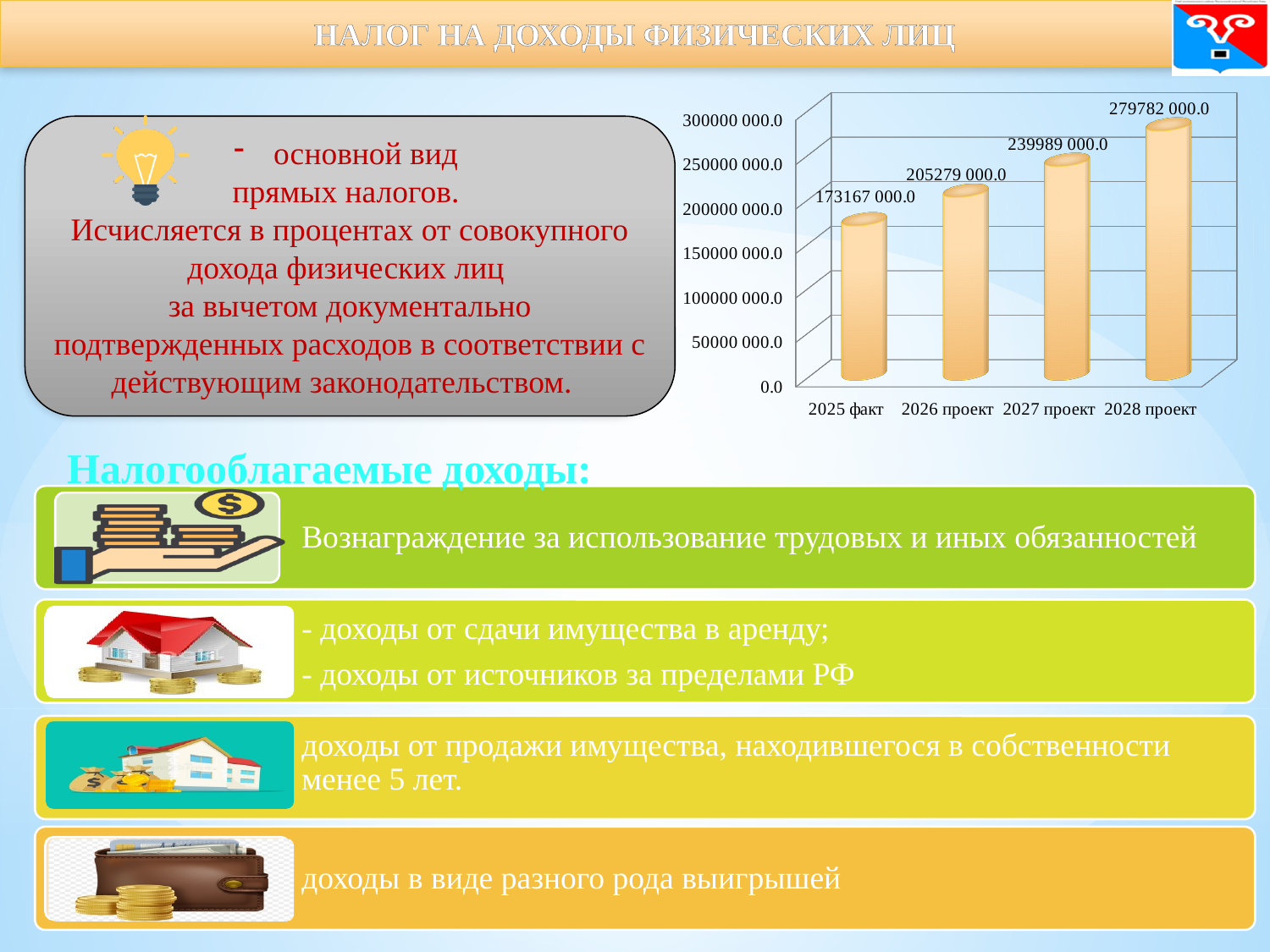
Do the values rise or fall from 2025 факт to 2028 проект? rise What is the difference between the values for 2028 проект and 2025 факт? 106615 000.0 How many categories are shown on the x axis of the chart? 4 Which is larger, the value for 2027 проект or the value for 2026 проект? 2027 проект What is the value shown for 2025 факт? 173167 000.0 What kind of chart is shown on the slide? bar chart What is the difference between the values for 2026 проект and 2025 факт? 32112 000.0 Which category has the highest value in the chart? 2028 проект What is the value shown for 2027 проект? 239989 000.0 Which category has the lowest value in the chart? 2025 факт What is the value shown for 2028 проект? 279782 000.0 What is the value shown for 2026 проект? 205279 000.0